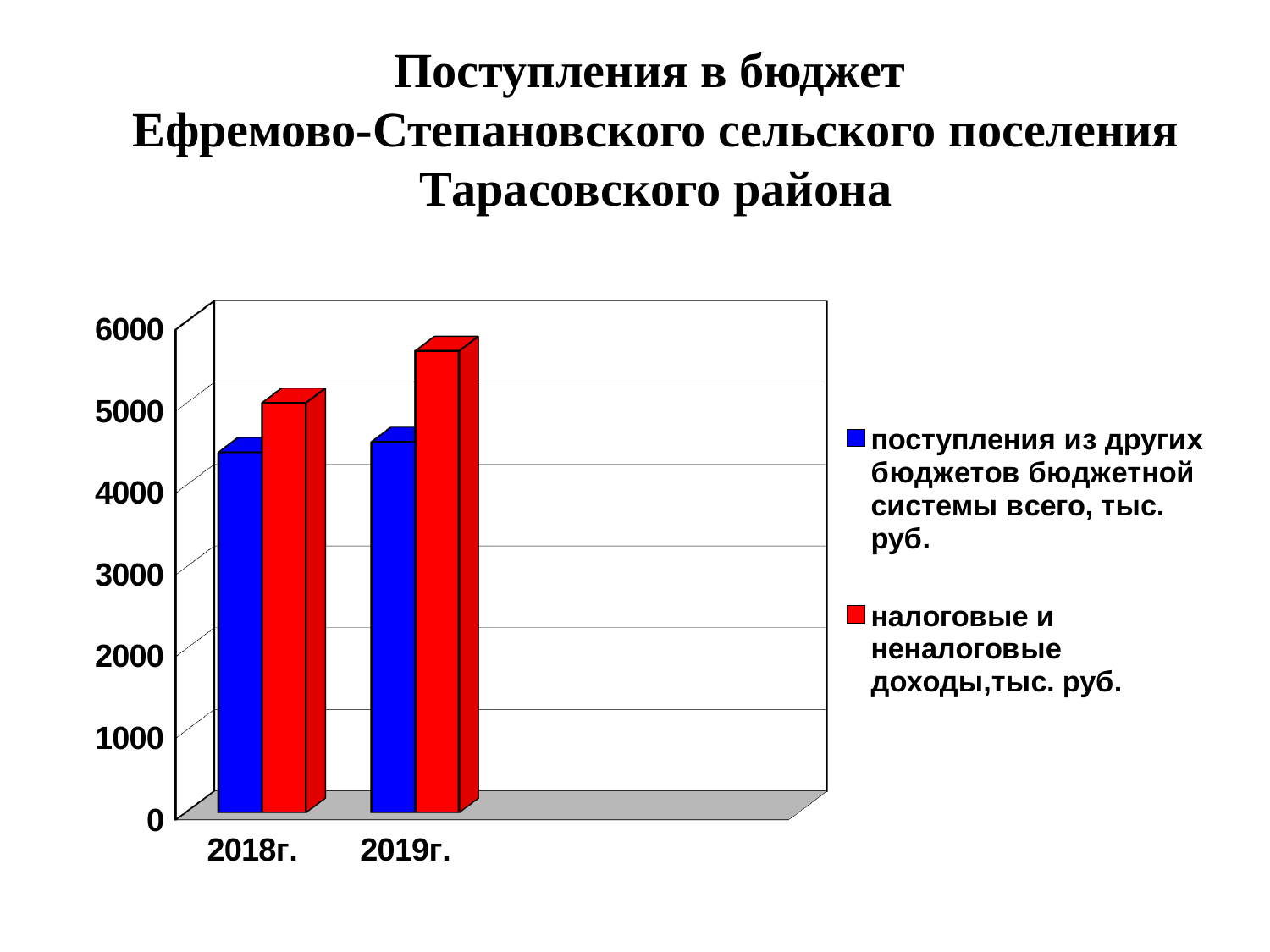
Is the value for "поступления из других бюджетов бюджетной системы всего" in 2018г. greater or less than 4000? greater Do the values for "налоговые и неналоговые доходы" rise or fall from 2018г. to 2019г.? rise How many years (categories) are shown on the x axis? 2 Is the value for "налоговые и неналоговые доходы" in 2019г. greater or less than 5000? greater Which bar is the highest on the chart? налоговые и неналоговые доходы in 2019г. Is the value for "поступления из других бюджетов бюджетной системы всего" in 2019г. greater or less than 5000? less How many series does the legend list? 2 Which colour represents "налоговые и неналоговые доходы, тыс. руб." in the legend? red What kind of chart is shown on the slide? bar chart In 2019г., which is larger: "поступления из других бюджетов бюджетной системы всего" or "налоговые и неналоговые доходы"? налоговые и неналоговые доходы